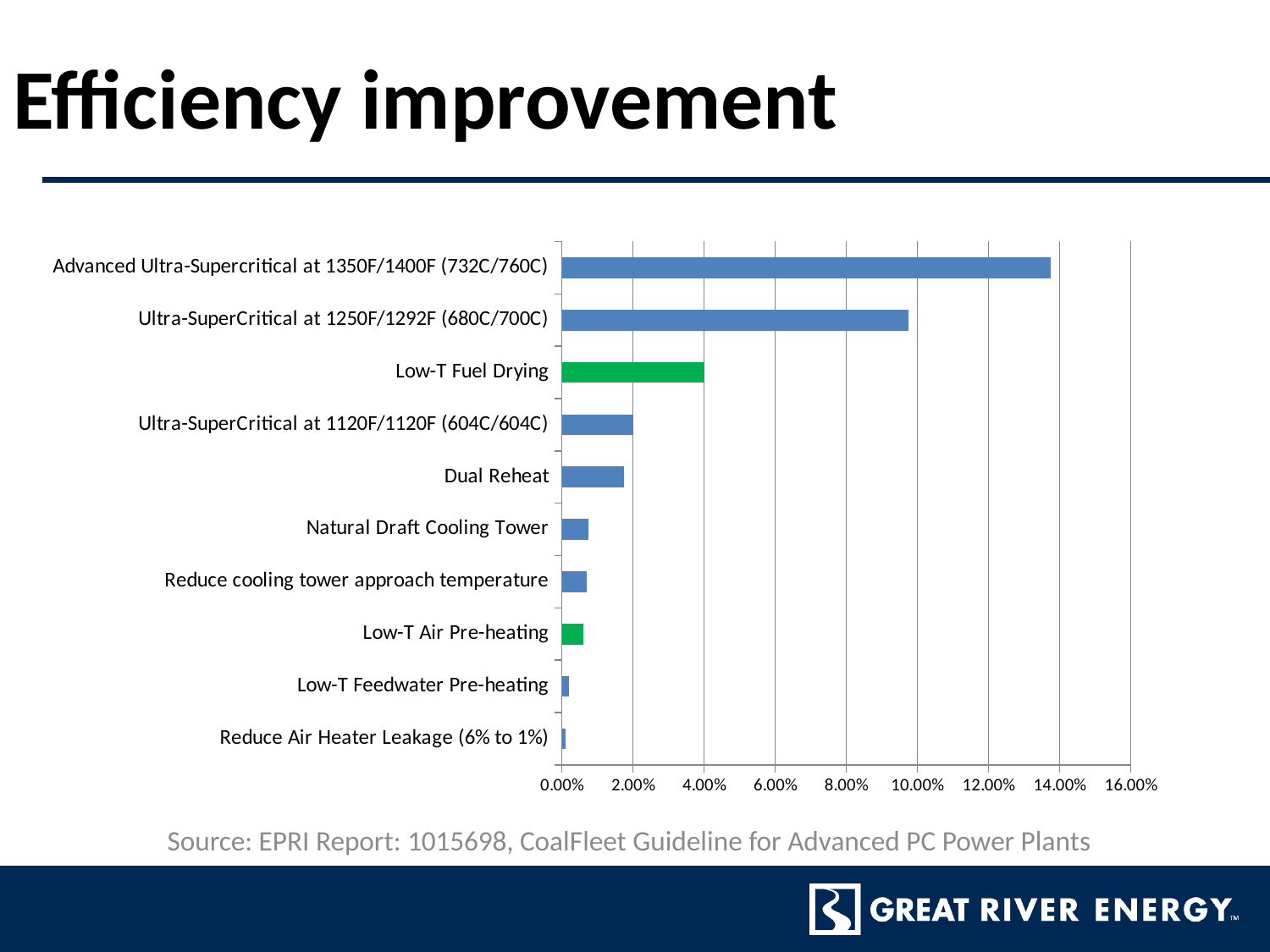
Is the value for Ultra-SuperCritical at 1250F/1292F (680C/700C) greater or less than 10.00%? less Which is larger, the value for Ultra-SuperCritical at 1250F/1292F (680C/700C) or the value for Advanced Ultra-Supercritical at 1350F/1400F (732C/760C)? Advanced Ultra-Supercritical at 1350F/1400F (732C/760C) Which category has the highest efficiency improvement? Advanced Ultra-Supercritical at 1350F/1400F (732C/760C) How many categories are plotted in the chart? 10 Which is larger, the value for Low-T Fuel Drying or the value for Dual Reheat? Low-T Fuel Drying What type of chart is shown on the slide? Bar chart What is the efficiency improvement value for Low-T Fuel Drying? 4.00% Is the value for Advanced Ultra-Supercritical at 1350F/1400F (732C/760C) greater or less than 12.00%? greater What is the efficiency improvement value for Ultra-SuperCritical at 1120F/1120F (604C/604C)? 2.00% Is the value for Dual Reheat greater or less than 2.00%? less Which category has the lowest efficiency improvement? Reduce Air Heater Leakage (6% to 1%) Which two categories are shown with green bars instead of blue? Low-T Fuel Drying and Low-T Air Pre-heating